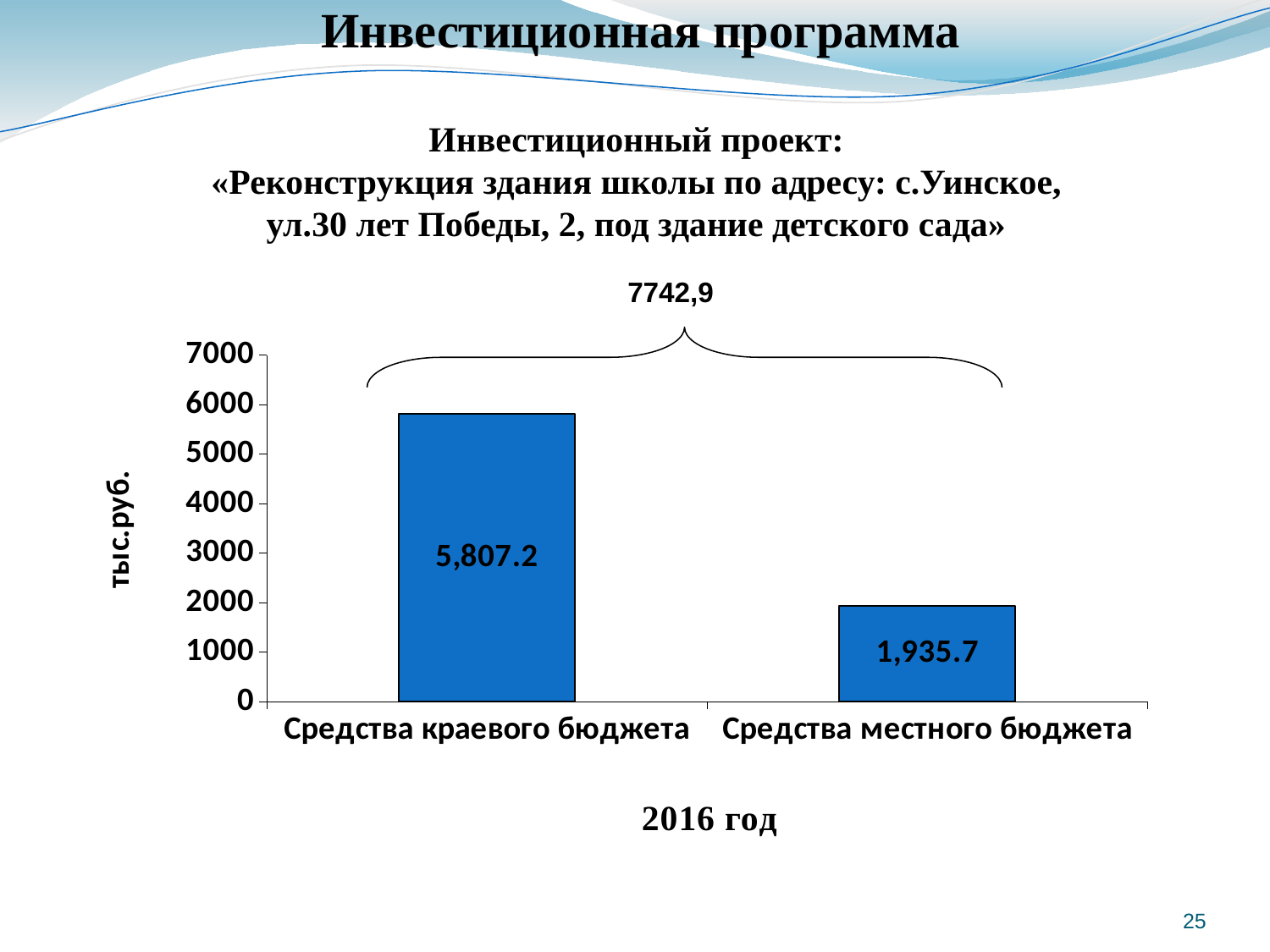
Which is larger: the value for Средства краевого бюджета or the value for Средства местного бюджета? Средства краевого бюджета What is the difference between the values for Средства краевого бюджета and Средства местного бюджета? 3,871.5 Is the value for Средства местного бюджета greater or less than 2000? less Which category has the highest value? Средства краевого бюджета Is the value for Средства краевого бюджета greater or less than 5000? greater What is the value for Средства краевого бюджета? 5,807.2 How many categories are shown on the chart? 2 What total is shown above the brace spanning both bars? 7742,9 Which category has the lowest value? Средства местного бюджета What is the value for Средства местного бюджета? 1,935.7 What kind of chart is shown on the slide? bar chart What is the label of the vertical axis? тыс.руб.